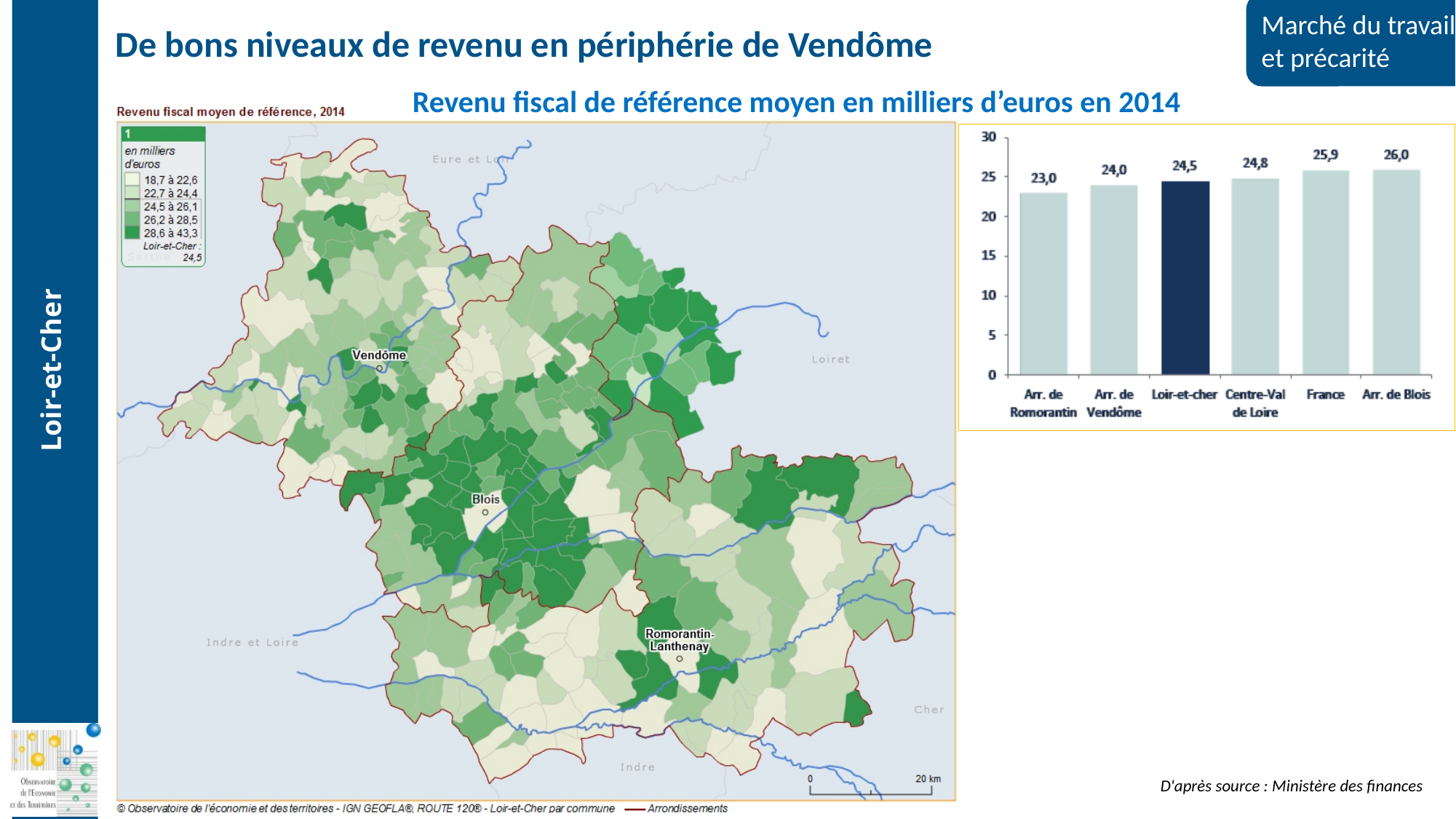
In the bar chart, which is larger, the value for Arr. de Vendôme or the value for Centre-Val de Loire? Centre-Val de Loire In the bar chart, what is the value for Loir-et-cher? 24,5 In the bar chart, which category has the highest value? Arr. de Blois In the bar chart, which category has the lowest value? Arr. de Romorantin How many categories are shown in the bar chart? 6 In the bar chart, what is the difference between the values for Arr. de Blois and Arr. de Romorantin? 3,0 In the bar chart, what is the value for Centre-Val de Loire? 24,8 What kind of chart is shown on the right side of the slide? Bar chart In the bar chart, what is the value for France? 25,9 In the bar chart, what is the difference between the values for France and Loir-et-cher? 1,4 In the bar chart, which bar is coloured dark navy blue rather than light green? Loir-et-cher In the bar chart, what is the value for Arr. de Romorantin? 23,0